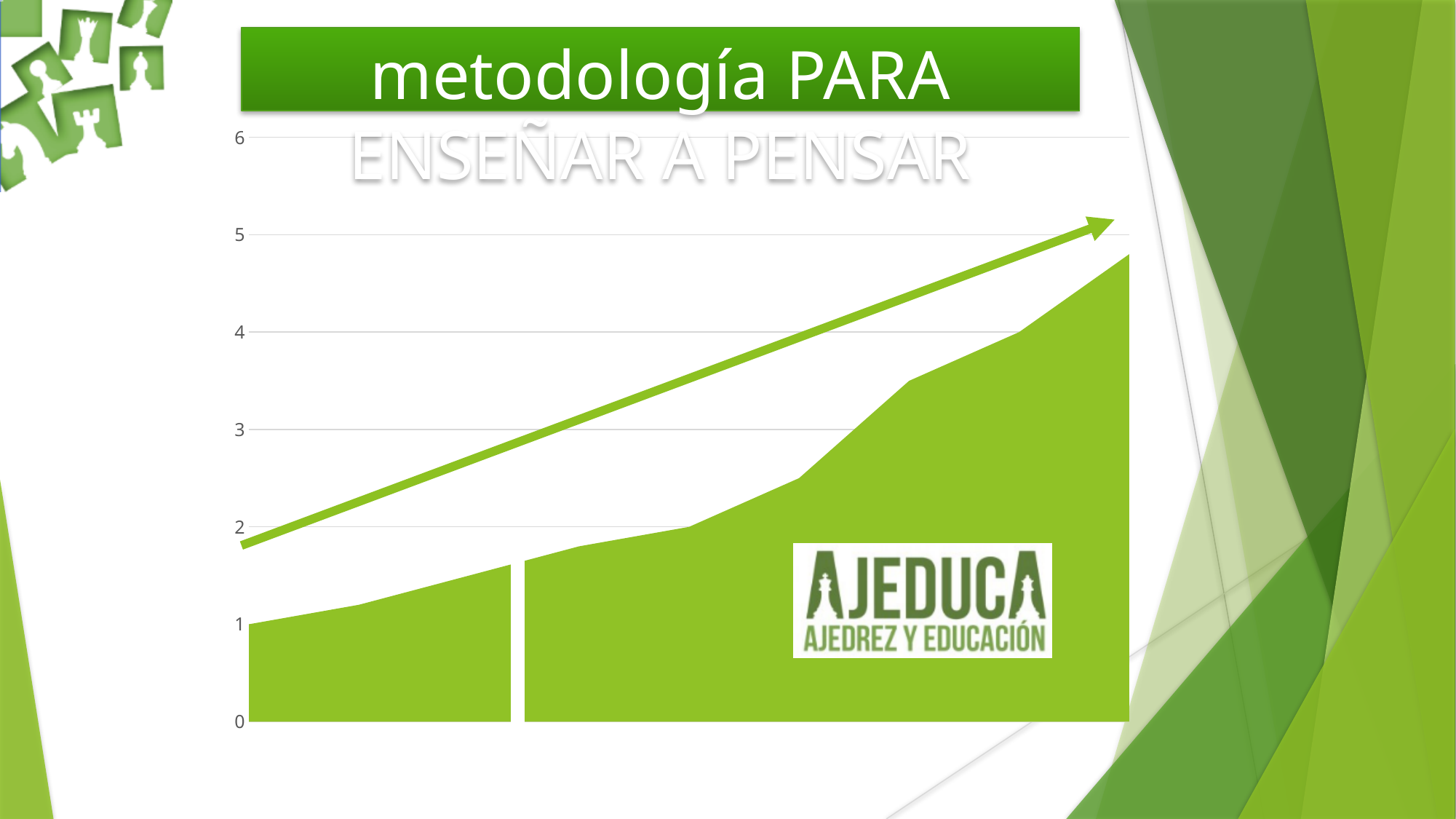
Is the value at the left end of the area chart greater or less than 2? less What is the highest value shown on the vertical axis? 6 Is the value at the right end of the area chart greater or less than 5? less Do the plotted values rise or fall from left to right along the x axis? rise What is the title shown above the chart? metodología PARA ENSEÑAR A PENSAR What kind of chart is shown on the slide? area chart Is the value at the right end of the area chart greater or less than 4? greater